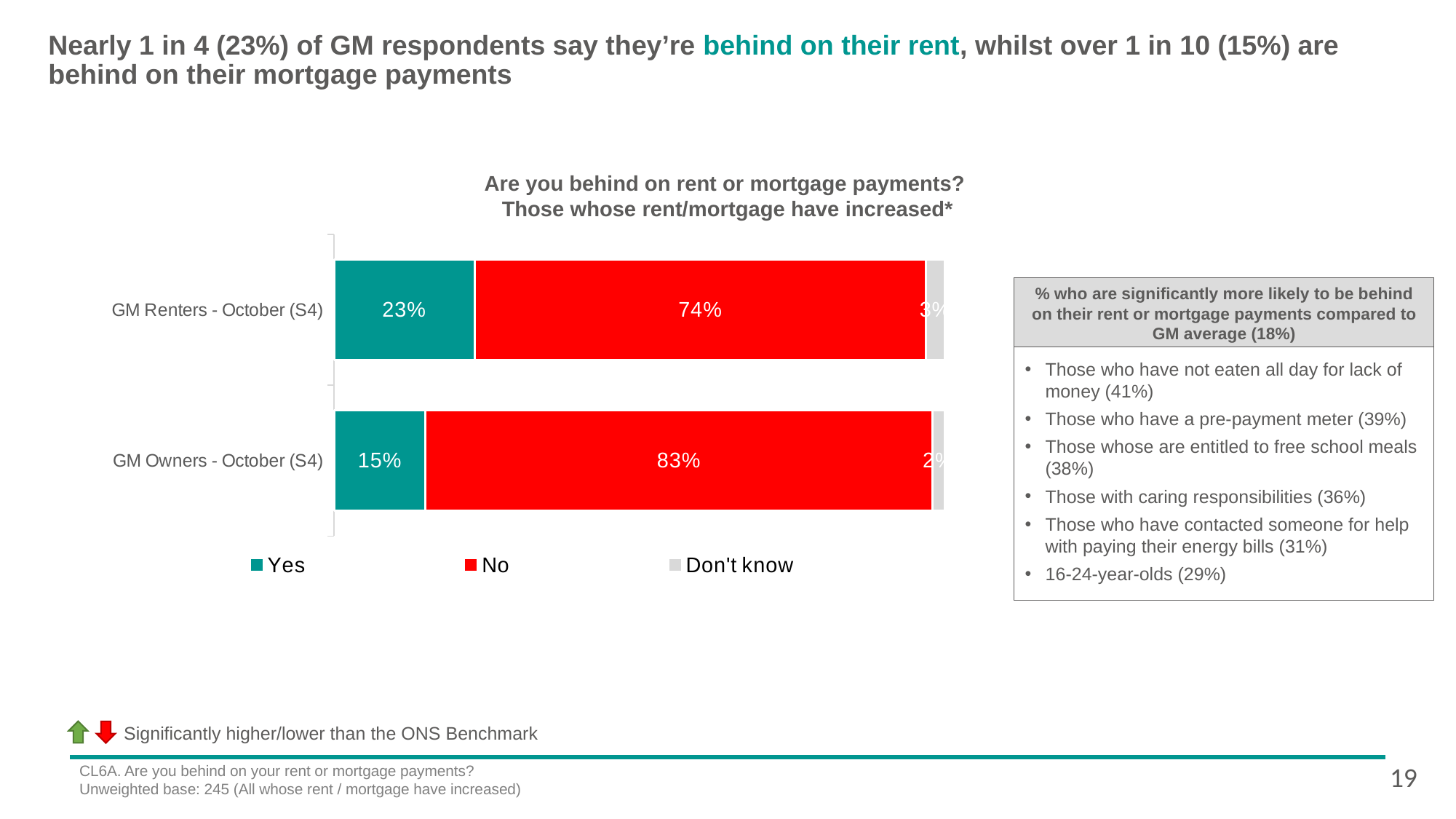
What percentage of GM Renters - October (S4) answered Yes to being behind on rent or mortgage payments? 23% What is the difference between the No share for GM Owners - October (S4) and GM Renters - October (S4)? 9 percentage points How many series does the legend list? 3 Which group has the larger Yes share: GM Renters - October (S4) or GM Owners - October (S4)? GM Renters - October (S4) What percentage of GM Owners - October (S4) answered No? 83% What kind of chart is shown on the slide? Stacked bar chart What is the Yes value for GM Owners - October (S4)? 15% Which category has the highest No share? GM Owners - October (S4) What are the three legend entries of the chart? Yes, No, Don't know How many categories (bars) are shown in the chart? 2 By how many percentage points does the Yes share for GM Renters - October (S4) exceed that for GM Owners - October (S4)? 8 percentage points What is the No value for GM Renters - October (S4)? 74%